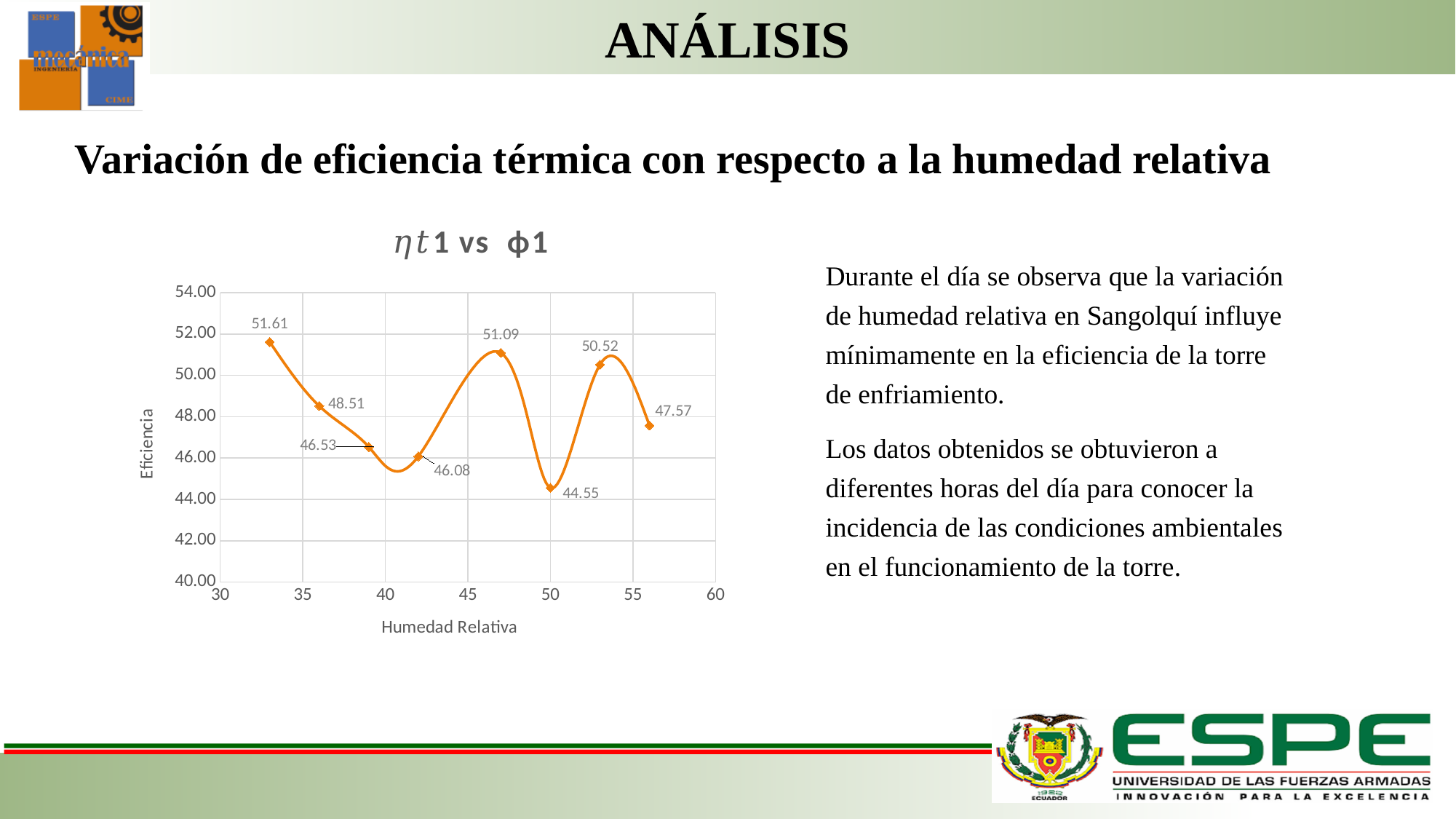
What is the efficiency value of the leftmost data point? 51.61 What is the lowest efficiency value plotted on the chart? 44.55 What is the highest efficiency value plotted on the chart? 51.61 Is the efficiency value at a relative humidity of 50 greater or less than 46? less Which is larger, the data point labelled 51.09 or the one labelled 50.52? 51.09 What is the difference between the highest and lowest efficiency values on the chart? 7.06 What is the efficiency value of the rightmost data point? 47.57 What is the difference between the data points labelled 48.51 and 46.53? 1.98 How many data points are plotted on the chart? 8 What kind of chart is shown on the slide? line chart What is the efficiency value at a relative humidity of 50? 44.55 What is the title of the x axis of the chart? Humedad Relativa